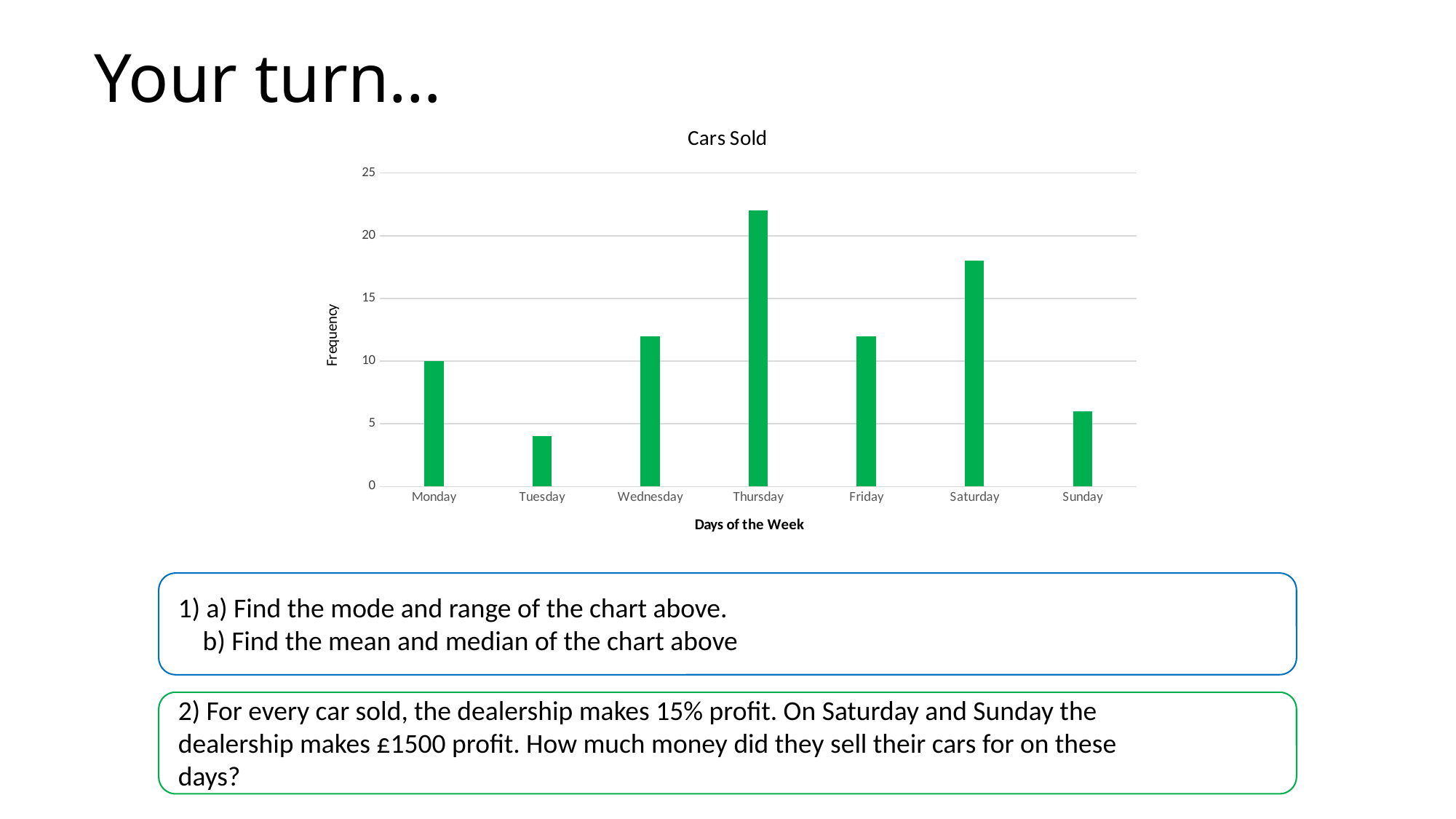
What is the frequency of cars sold on Monday? 10 What is the title of the chart? Cars Sold Is the value for Sunday greater or less than 10? less Is the value for Thursday greater or less than 20? greater Is the value for Tuesday greater or less than 5? less Which is larger, the value for Saturday or the value for Sunday? Saturday What type of chart is shown on the slide? bar chart Which day has the highest number of cars sold? Thursday What is the label on the y axis of the chart? Frequency How many days are shown on the x axis of the chart? 7 Which day has the lowest number of cars sold? Tuesday